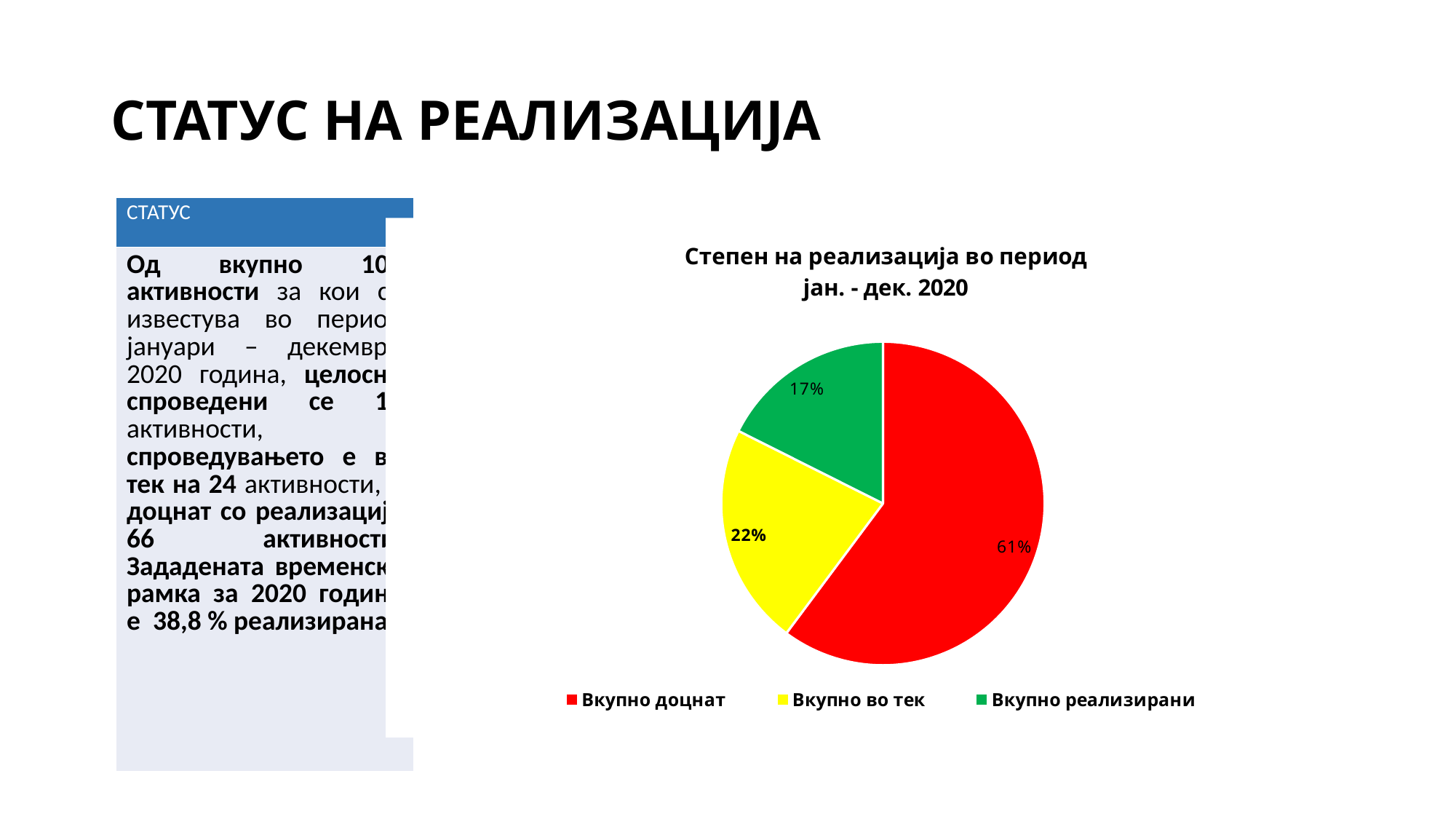
What is the difference in percentage points between Вкупно во тек and Вкупно реализирани? 5 What percentage is shown for Вкупно во тек? 22% What percentage is shown for Вкупно доцнат? 61% What type of chart is shown on the slide? pie chart What is the difference in percentage points between Вкупно доцнат and Вкупно во тек? 39 How many slices does the pie chart have? 3 What colour is the slice for Вкупно реализирани? green Which is larger, the share for Вкупно во тек or the share for Вкупно реализирани? Вкупно во тек What is the title of the chart? Степен на реализација во период јан. - дек. 2020 Which category has the largest share of the pie? Вкупно доцнат Which category has the smallest share of the pie? Вкупно реализирани What percentage is shown for Вкупно реализирани? 17%